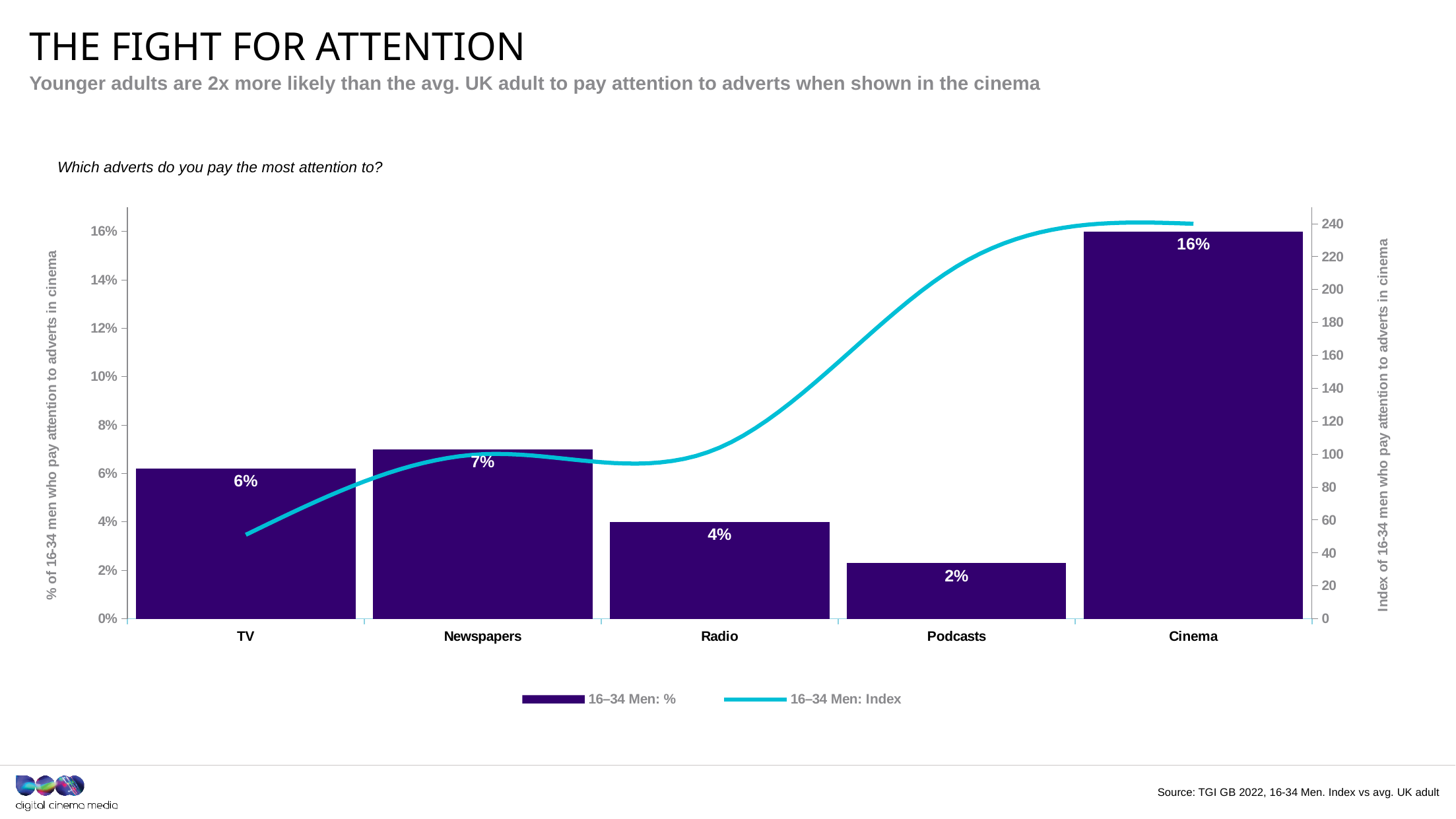
Is the 16–34 Men: Index value for TV greater or less than 80? less Is the 16–34 Men: Index value for Cinema greater or less than 200? greater What is the value of the 16–34 Men: % bar for Podcasts? 2% Which category has the highest 16–34 Men: % bar? Cinema How many advert categories are shown on the x axis? 5 What question is the chart answering, as written above it? Which adverts do you pay the most attention to? How many series does the legend list? 2 Which has a higher 16–34 Men: % value, Newspapers or Radio? Newspapers What is the difference between the 16–34 Men: % values for Cinema and TV? 10% Which category has the lowest 16–34 Men: % bar? Podcasts What percentage of 16-34 men pay the most attention to adverts in the cinema? 16% What kind of chart is shown on the slide? A combined bar and line chart